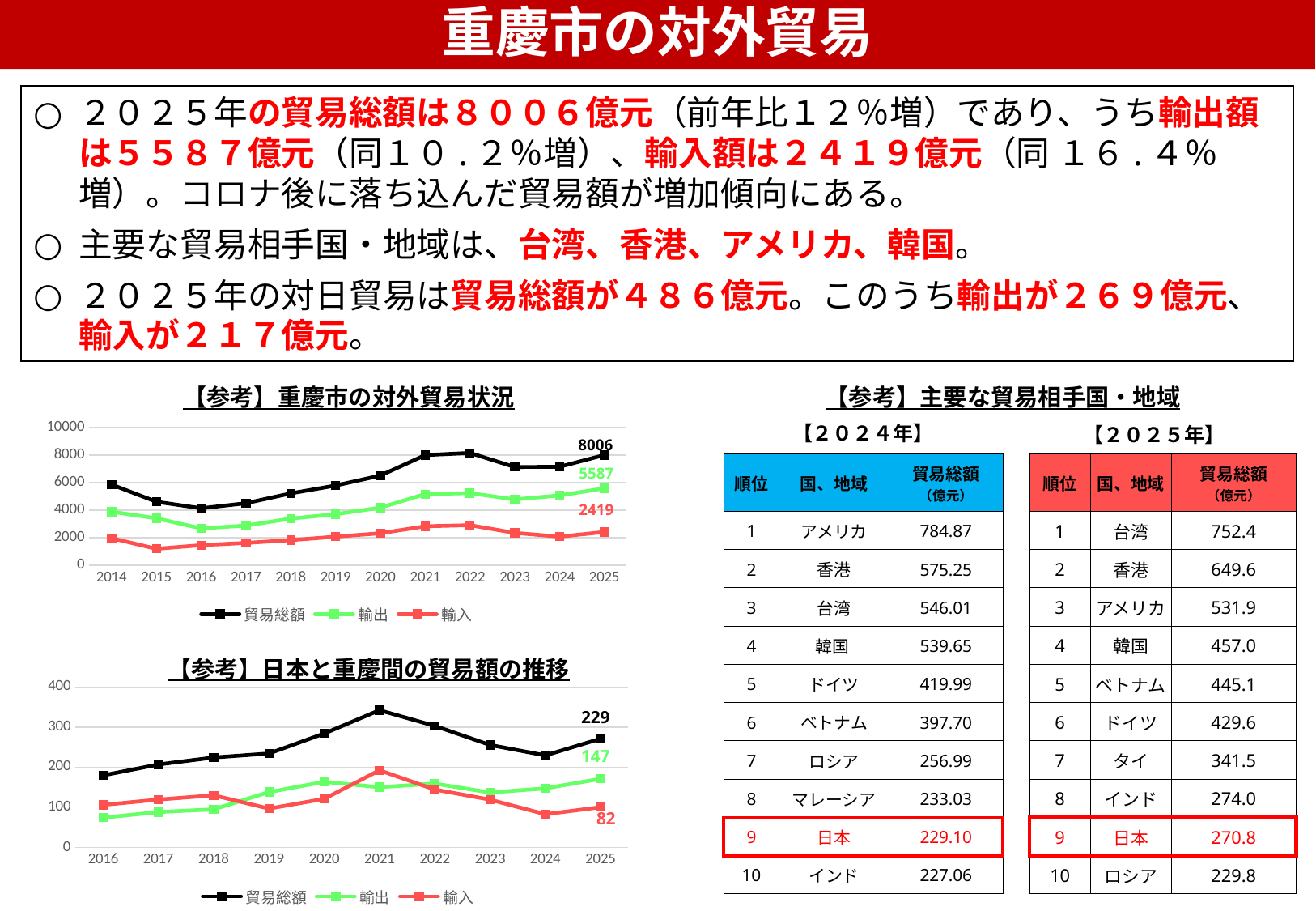
In the chart titled 【参考】重慶市の対外貿易状況, in which year is 貿易総額 lowest? 2016 In the chart titled 【参考】重慶市の対外貿易状況, is the value of 貿易総額 for 2016 greater or less than 6000? less In the chart titled 【参考】重慶市の対外貿易状況, what is the value of 貿易総額 for 2025? 8006 What kind of chart is 【参考】日本と重慶間の貿易額の推移? line chart In the chart titled 【参考】日本と重慶間の貿易額の推移, in which year is 貿易総額 highest? 2021 In the chart titled 【参考】重慶市の対外貿易状況, what is the difference between 輸出 and 輸入 in 2025? 3168 In the chart titled 【参考】重慶市の対外貿易状況, what is the value of 輸出 for 2025? 5587 In the chart titled 【参考】重慶市の対外貿易状況, how many series does the legend list? 3 In the chart titled 【参考】重慶市の対外貿易状況, how many years are plotted on the x axis? 12 In the chart titled 【参考】日本と重慶間の貿易額の推移, which is larger in 2025, 輸出 or 輸入? 輸出 In the chart titled 【参考】重慶市の対外貿易状況, what is the value of 輸入 for 2025? 2419